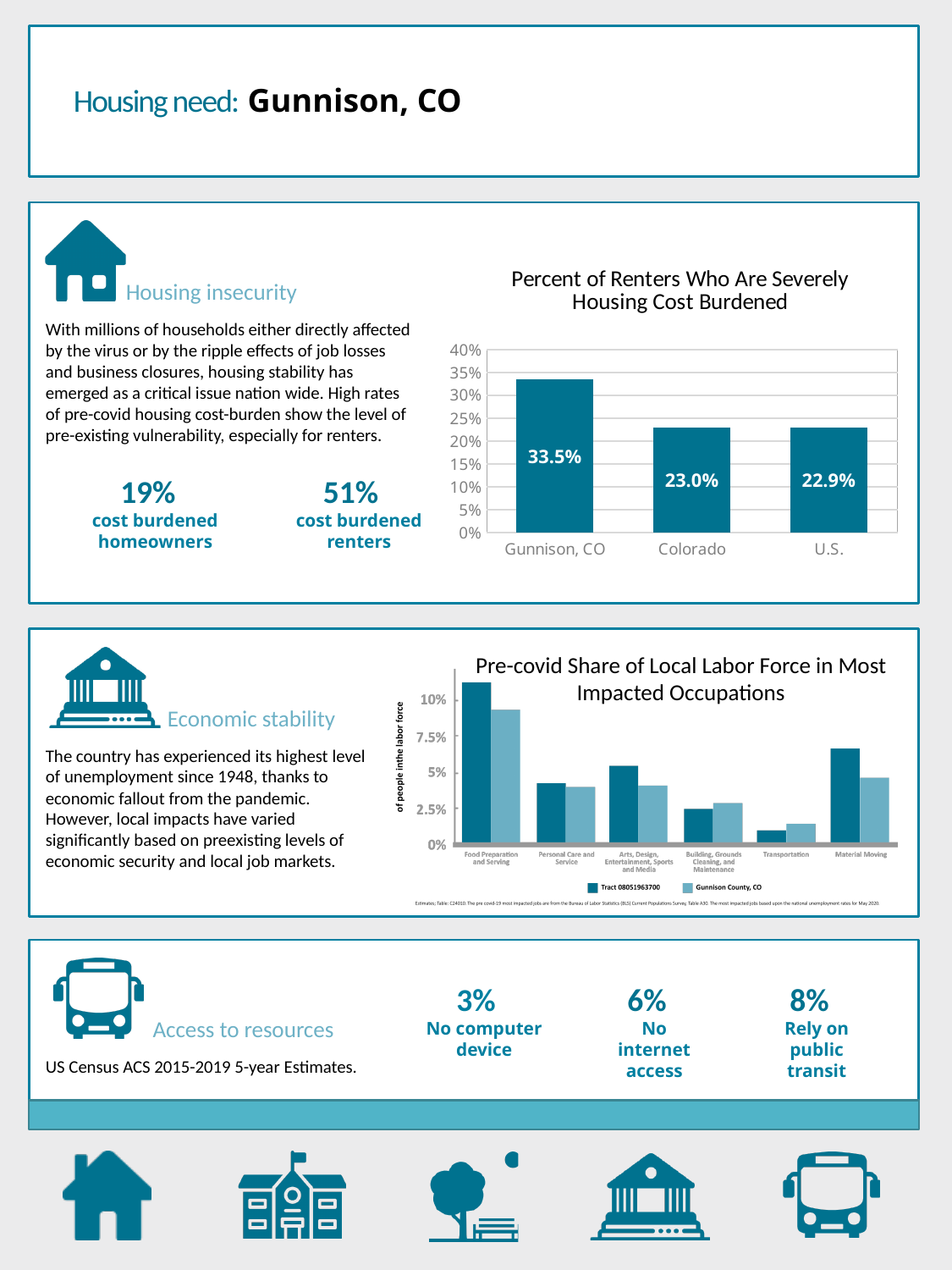
In the chart 'Pre-covid Share of Local Labor Force in Most Impacted Occupations', what are the two series named in the legend? Tract 08051963700 and Gunnison County, CO What kind of chart is 'Percent of Renters Who Are Severely Housing Cost Burdened'? Bar chart In the chart 'Pre-covid Share of Local Labor Force in Most Impacted Occupations', is the Tract 08051963700 value for Food Preparation and Serving greater or less than 10%? greater In the chart 'Pre-covid Share of Local Labor Force in Most Impacted Occupations', how many occupation categories are shown? 6 In the chart 'Percent of Renters Who Are Severely Housing Cost Burdened', what is the difference between the values for Gunnison, CO and Colorado? 10.5% In the chart 'Pre-covid Share of Local Labor Force in Most Impacted Occupations', which occupation has the lowest value for Tract 08051963700? Transportation In the chart 'Percent of Renters Who Are Severely Housing Cost Burdened', what is the value for Colorado? 23.0% In the chart 'Percent of Renters Who Are Severely Housing Cost Burdened', what is the value for Gunnison, CO? 33.5% In the chart 'Percent of Renters Who Are Severely Housing Cost Burdened', which category has the highest value? Gunnison, CO In the chart 'Percent of Renters Who Are Severely Housing Cost Burdened', how many categories are shown on the x axis? 3 In the chart 'Pre-covid Share of Local Labor Force in Most Impacted Occupations', how many series does the legend list? 2 In the chart 'Percent of Renters Who Are Severely Housing Cost Burdened', what is the value for U.S.? 22.9%